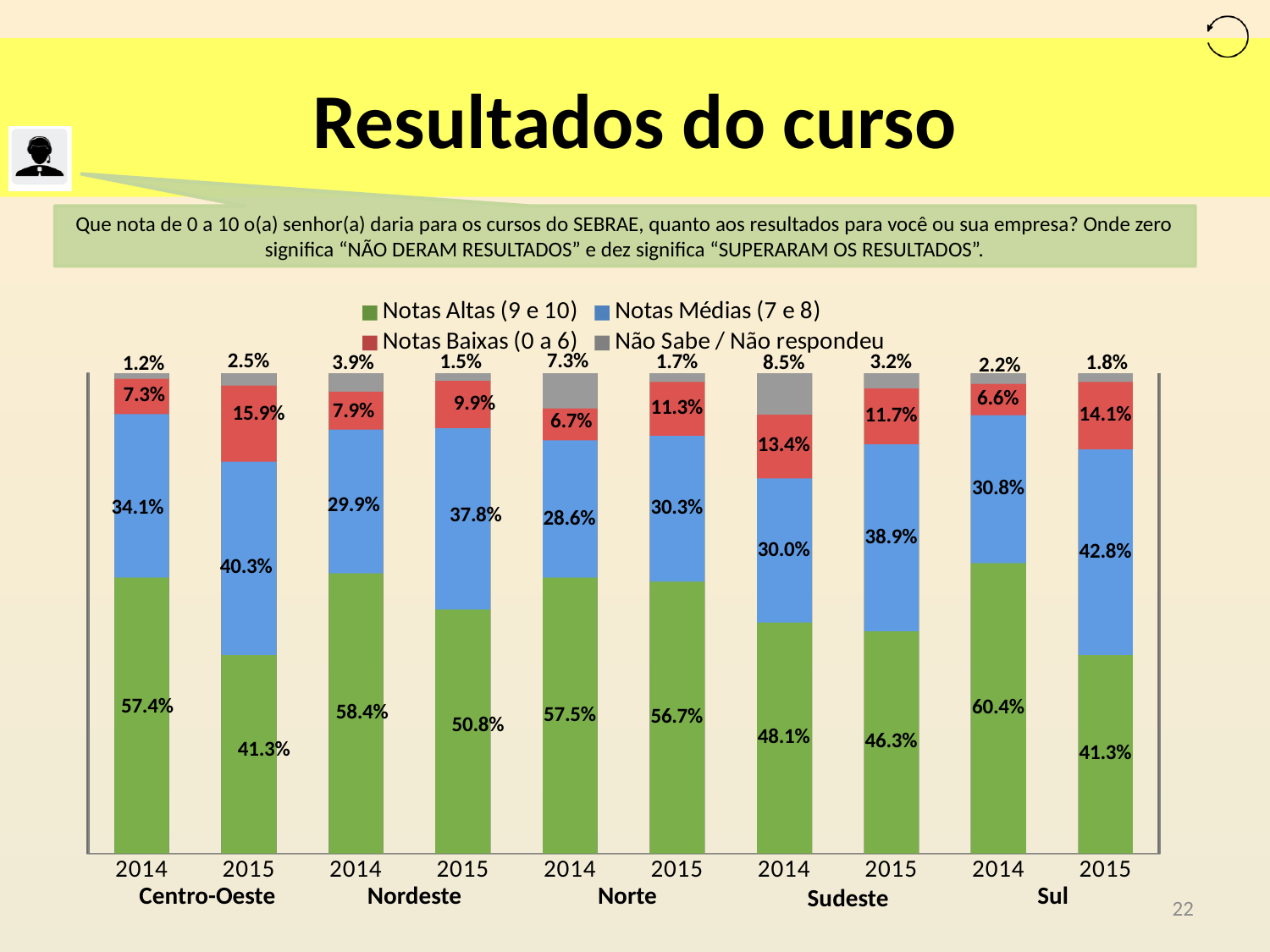
What is the value of Notas Altas (9 e 10) for Sul in 2014? 60.4% Which region and year has the highest value for Notas Baixas (0 a 6)? Centro-Oeste 2015 What is the value of Não Sabe / Não respondeu for Sudeste in 2014? 8.5% What is the value of Notas Médias (7 e 8) for Nordeste in 2015? 37.8% What kind of chart is shown on the slide? Stacked bar chart What is the difference between the Notas Altas (9 e 10) values for Sul in 2014 and 2015? 19.1 percentage points What is the value of Notas Baixas (0 a 6) for Centro-Oeste in 2015? 15.9% How many bars are plotted in the chart? 10 Which is larger for Nordeste: the Notas Médias (7 e 8) value in 2014 or in 2015? 2015 Which region and year has the highest value for Notas Altas (9 e 10)? Sul 2014 Which region and year has the lowest value for Não Sabe / Não respondeu? Centro-Oeste 2014 How many series does the legend list? 4